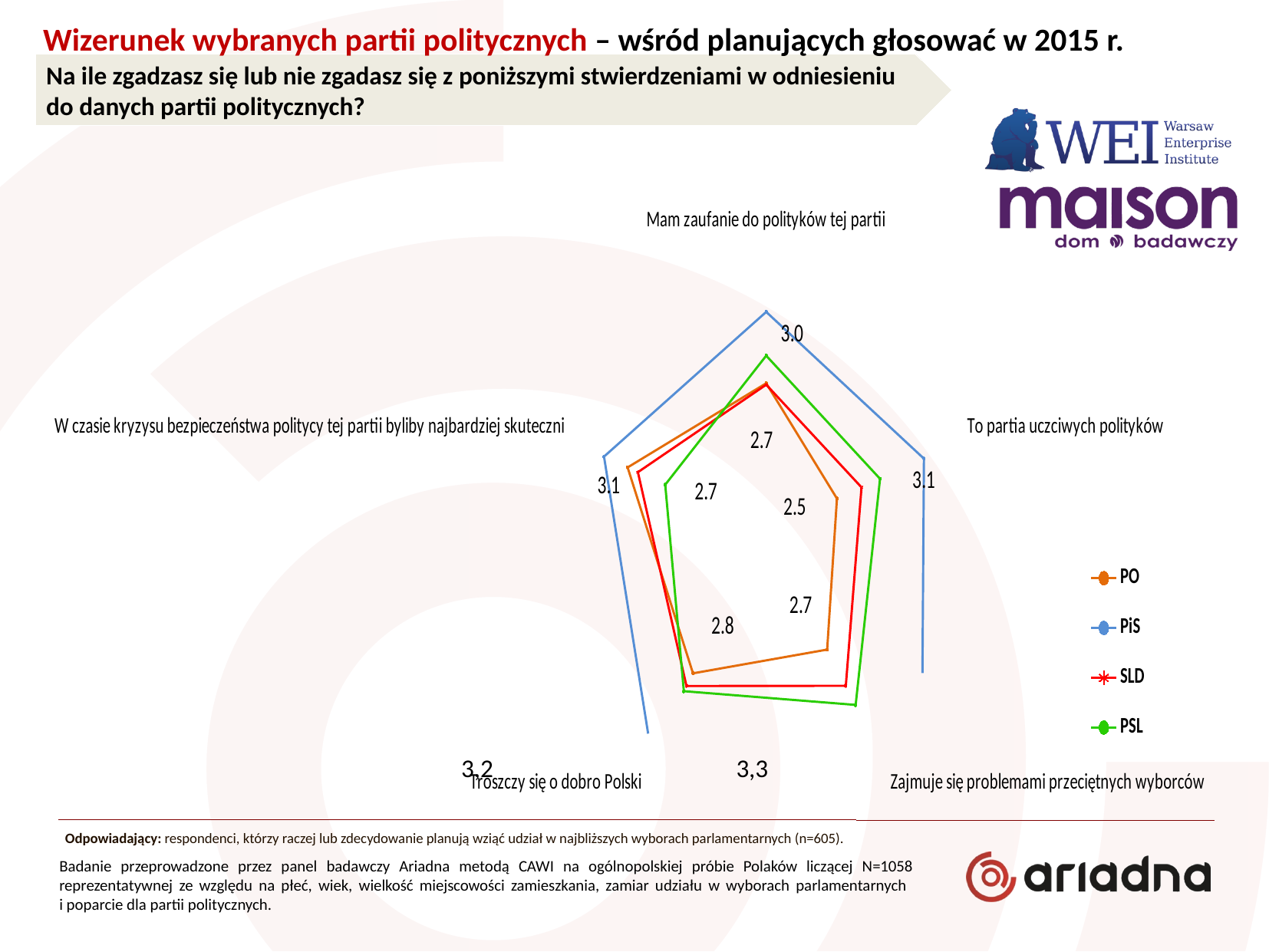
How many series does the legend list? 4 What is the value for PiS on "W czasie kryzysu bezpieczeństwa politycy tej partii byliby najbardziej skuteczni"? 3.1 Which party has the highest value for "Zajmuje się problemami przeciętnych wyborców"? PiS What is the value for PiS on "To partia uczciwych polityków"? 3.1 What kind of chart is shown on the slide? radar chart Which party has the lowest value for "To partia uczciwych polityków"? PO Which is larger on "Mam zaufanie do polityków tej partii": the value for PiS or the value for PO? PiS What is the value for PiS on "Mam zaufanie do polityków tej partii"? 3.0 Which parties are listed in the legend? PO, PiS, SLD, PSL What colour is the line for PSL? green Which party has the highest value for "Mam zaufanie do polityków tej partii"? PiS How many statements (axes) does the radar chart have? 5